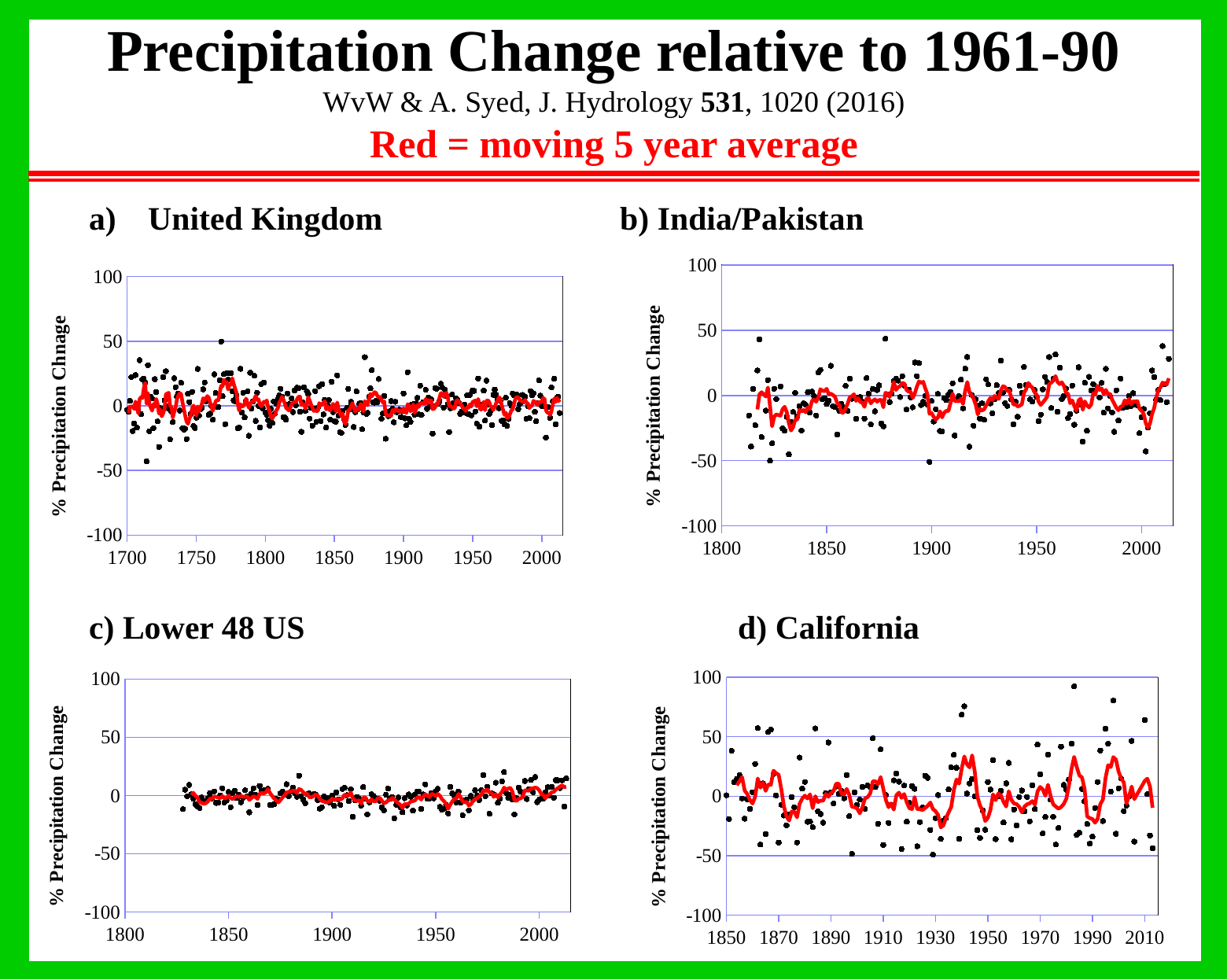
What kind of chart is the United Kingdom chart (a)? scatter chart with a moving-average line According to the slide, what does the red line in each chart represent? moving 5 year average In the Lower 48 US chart (c), does the red moving average at the right end of the series lie above or below 0? above Which chart shows the widest scatter of data points: Lower 48 US (c) or California (d)? California (d) In the California chart (d), is the highest data point greater or less than 50? greater In the California chart (d), what is the earliest year shown on the x-axis? 1850 In the Lower 48 US chart (c), is the highest data point greater or less than 50? less What is the label on the y-axis of the India/Pakistan chart (b)? % Precipitation Change How many charts are shown on the slide? 4 In the Lower 48 US chart (c), what is the maximum value shown on the y-axis? 100 In the United Kingdom chart (a), what is the earliest year shown on the x-axis? 1700